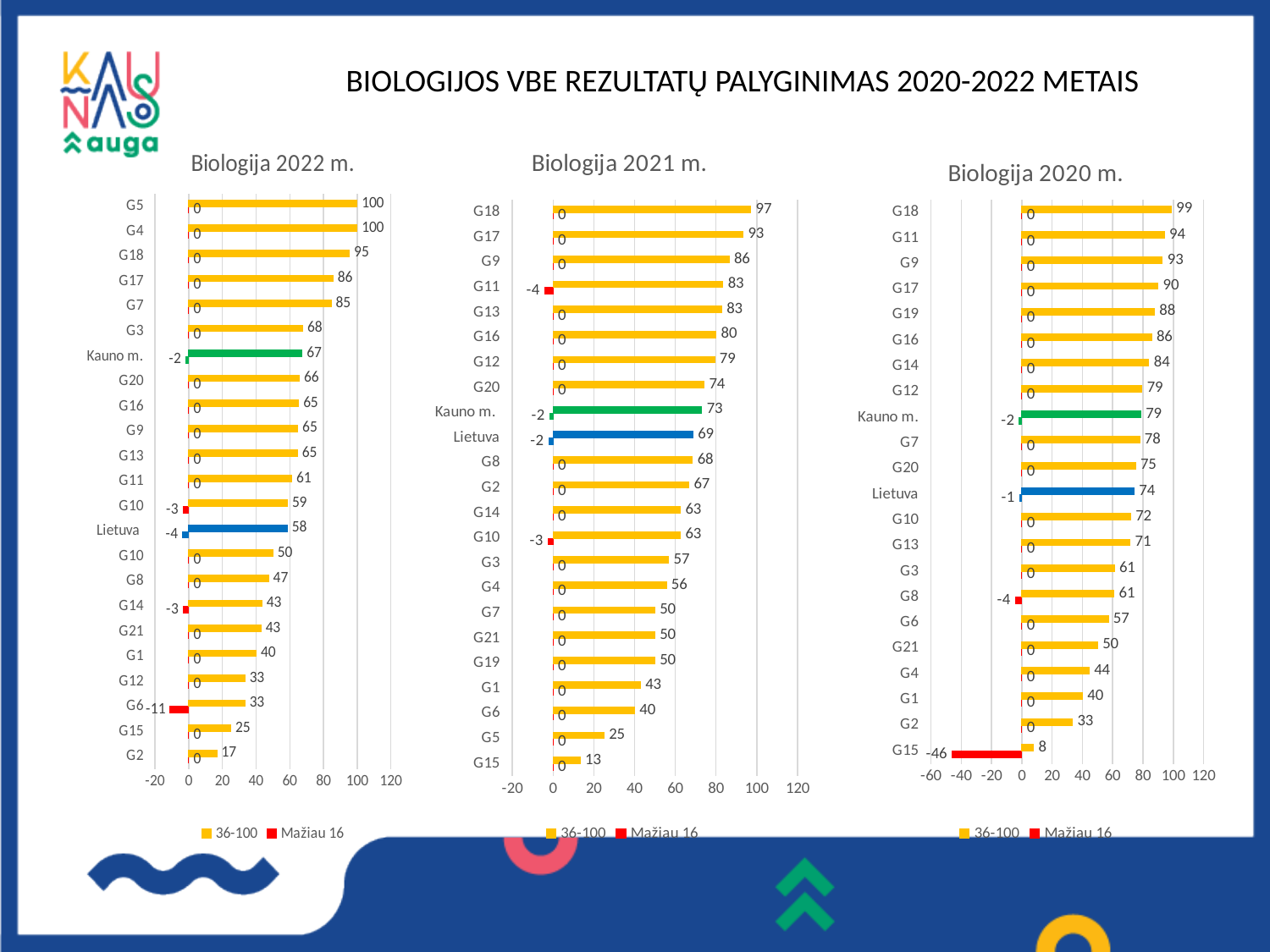
In the "Biologija 2022 m." chart, what is the Mažiau 16 value for G6? -11 In the "Biologija 2021 m." chart, which category has the highest 36-100 value? G18 In the "Biologija 2020 m." chart, what is the Mažiau 16 value for G15? -46 What are the two legend entries in the "Biologija 2020 m." chart? 36-100 and Mažiau 16 In the "Biologija 2022 m." chart, what is the difference between the 36-100 values for G18 and G2? 78 In the "Biologija 2020 m." chart, which has the larger 36-100 value, Kauno m. or Lietuva? Kauno m. In the "Biologija 2021 m." chart, what is the 36-100 value for Lietuva? 69 How many categories are shown in the "Biologija 2020 m." chart? 22 How many series does the legend of the "Biologija 2021 m." chart list? 2 In the "Biologija 2022 m." chart, what is the 36-100 value for Kauno m.? 67 What type of chart is "Biologija 2022 m."? Bar chart In the "Biologija 2020 m." chart, which category has the lowest 36-100 value? G15